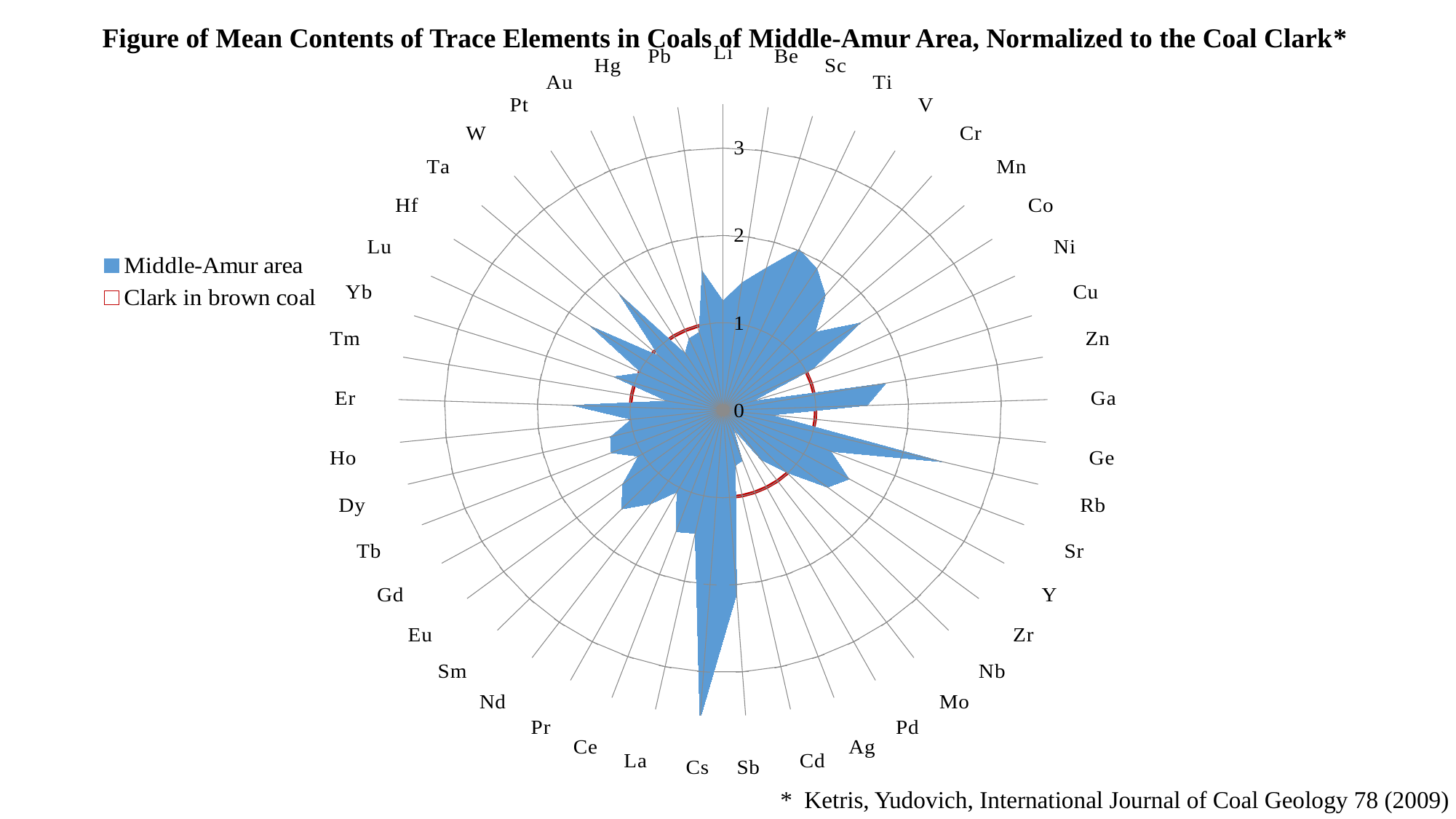
What is the highest tick value shown on the radial axis? 3 Which element has the highest Middle-Amur area value? Cs Is the Middle-Amur area value for Ga greater or less than 1? greater Which is larger, the Middle-Amur area value for Cs or for Ge? Cs How many elements (categories) are plotted around the radar chart? 45 Is the Clark in brown coal value for Cs greater or less than 2? less How many series does the legend list? 2 Which series is drawn in blue? Middle-Amur area Is the Middle-Amur area value for Ge greater or less than 2? less What kind of chart is shown on the slide? radar chart